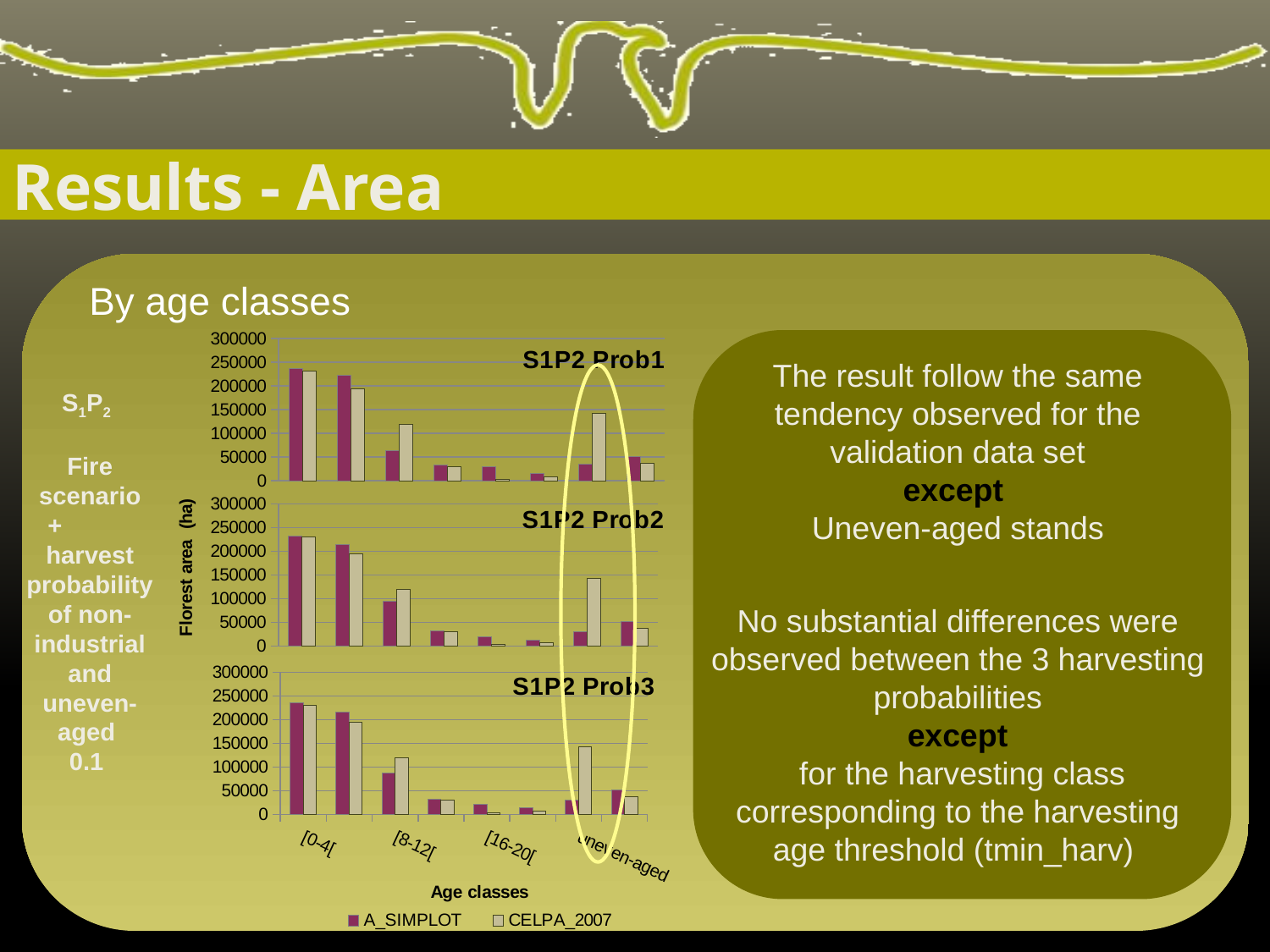
What kind of chart is the S1P2 Prob1 chart? bar chart In the S1P2 Prob1 chart, which age class has the highest A_SIMPLOT value? [0-4[ In the S1P2 Prob2 chart, is the CELPA_2007 value for [16-20[ greater or less than 50000? less In the S1P2 Prob1 chart, for the uneven-aged class, which series has the larger value, A_SIMPLOT or CELPA_2007? CELPA_2007 How many series does the legend list for the charts? 2 What are the two series named in the legend? A_SIMPLOT and CELPA_2007 In the S1P2 Prob2 chart, for the [8-12[ class, which series has the larger value, A_SIMPLOT or CELPA_2007? CELPA_2007 In the S1P2 Prob3 chart, is the A_SIMPLOT value for [8-12[ greater or less than 150000? less In the S1P2 Prob3 chart, is the A_SIMPLOT value for uneven-aged greater or less than 100000? less What is the y-axis title of the charts? Florest area (ha)